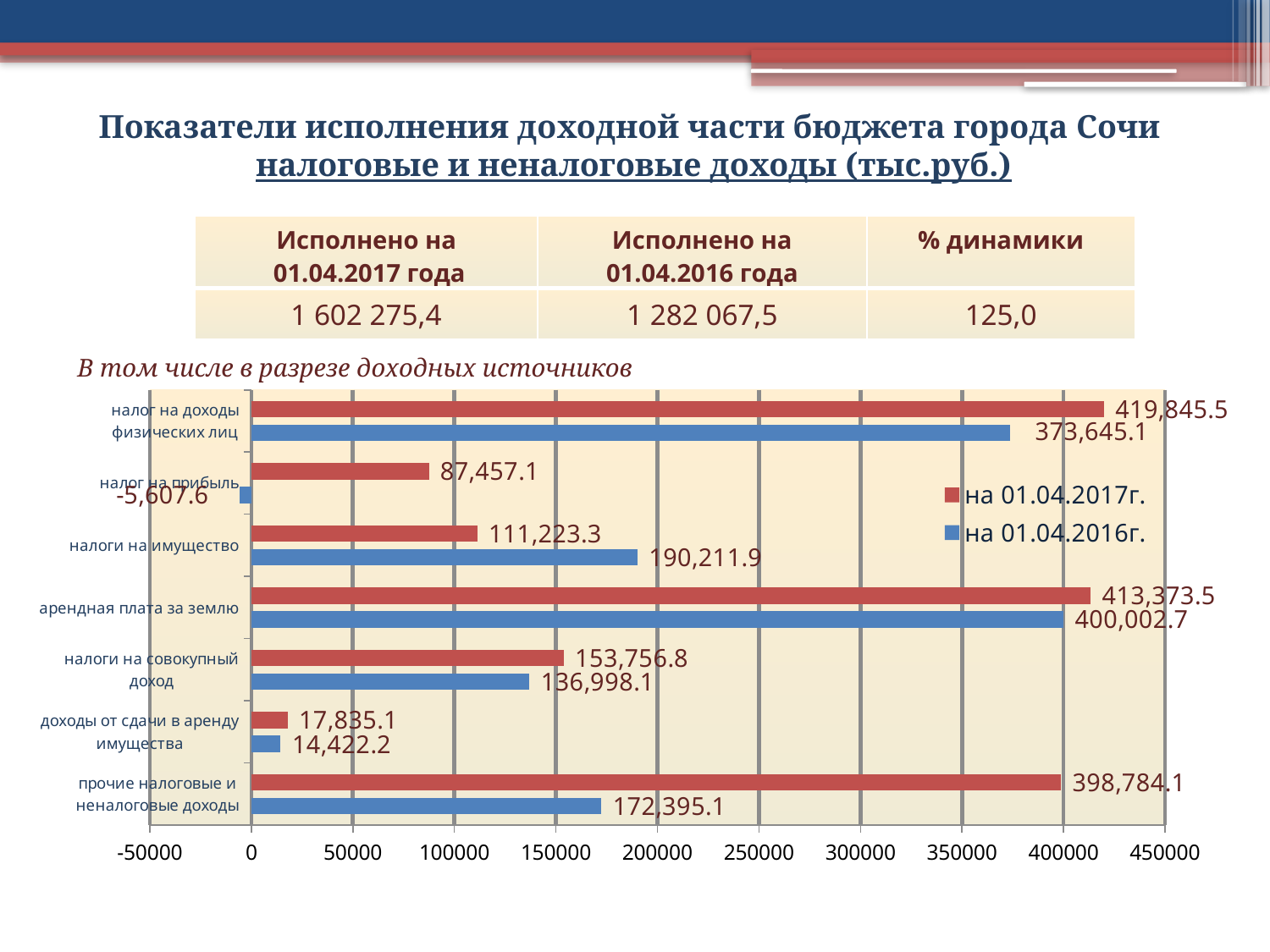
What is the difference between the 2017 and 2016 values for прочие налоговые и неналоговые доходы? 226,389.0 Is the value for налоги на совокупный доход in the series на 01.04.2017г. greater or less than 150000? greater What is the difference between the 2016 and 2017 values for налоги на имущество? 78,988.6 What is the value for налоги на имущество in the series на 01.04.2016г.? 190,211.9 For арендная плата за землю, which series has the larger value, на 01.04.2017г. or на 01.04.2016г.? на 01.04.2017г. Which category has the lowest value in the series на 01.04.2016г.? налог на прибыль How many categories are shown on the chart? 7 What is the value for налог на доходы физических лиц in the series на 01.04.2017г.? 419,845.5 What type of chart is shown on the slide? bar chart What is the value for налог на прибыль in the series на 01.04.2016г.? -5,607.6 How many series does the chart legend list? 2 Which category has the highest value in the series на 01.04.2017г.? налог на доходы физических лиц